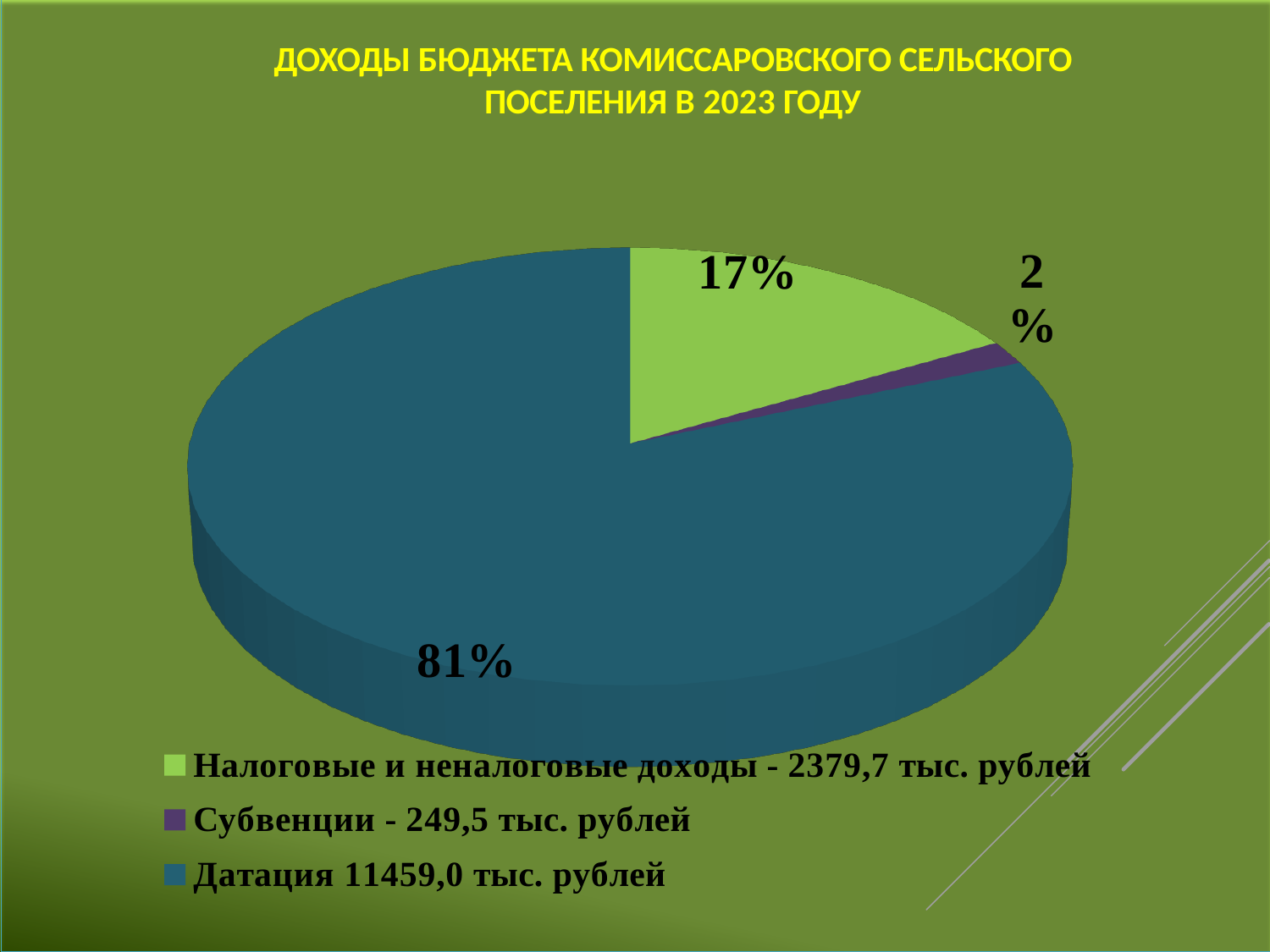
What share of the pie is labelled for Датация? 81% Which category has the largest slice of the pie? Датация What is the title of the chart? ДОХОДЫ БЮДЖЕТА КОМИССАРОВСКОГО СЕЛЬСКОГО ПОСЕЛЕНИЯ В 2023 ГОДУ What amount in тыс. рублей is given in the legend for Датация? 11459,0 тыс. рублей How many entries does the legend list? 3 Which is larger, the share for Налоговые и неналоговые доходы or the share for Субвенции? Налоговые и неналоговые доходы Which category has the smallest slice of the pie? Субвенции What share of the pie is labelled for Налоговые и неналоговые доходы? 17% What amount in тыс. рублей is given in the legend for Субвенции? 249,5 тыс. рублей What kind of chart is shown on the slide? pie chart How many slices does the pie chart have? 3 What share of the pie is labelled for Субвенции? 2%